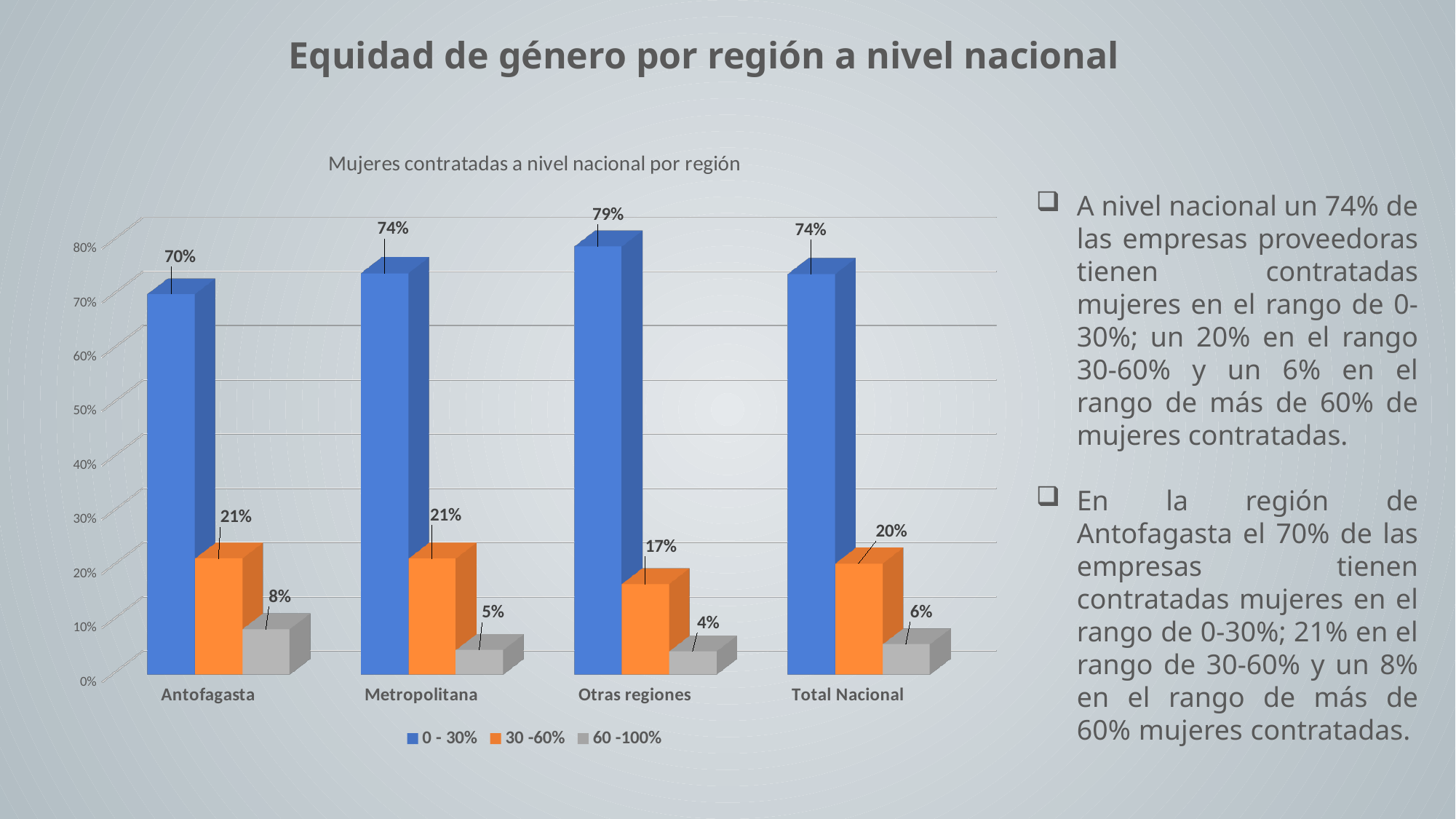
What is the value for the 60 -100% series in Total Nacional? 6% Which region has the lowest value for the 60 -100% series? Otras regiones What is the value for the 30 -60% series in Otras regiones? 17% What kind of chart is shown on the slide? Bar chart What is the title of the chart? Mujeres contratadas a nivel nacional por región Which is larger: the 60 -100% value for Antofagasta or for Metropolitana? Antofagasta What is the difference between the 0 - 30% values for Otras regiones and Antofagasta? 9% How many regions (categories) are shown on the x axis? 4 Which region has the highest value for the 0 - 30% series? Otras regiones What is the value for the 0 - 30% series in Antofagasta? 70% Is the 0 - 30% value for Metropolitana greater or less than 70%? greater How many series does the legend list? 3